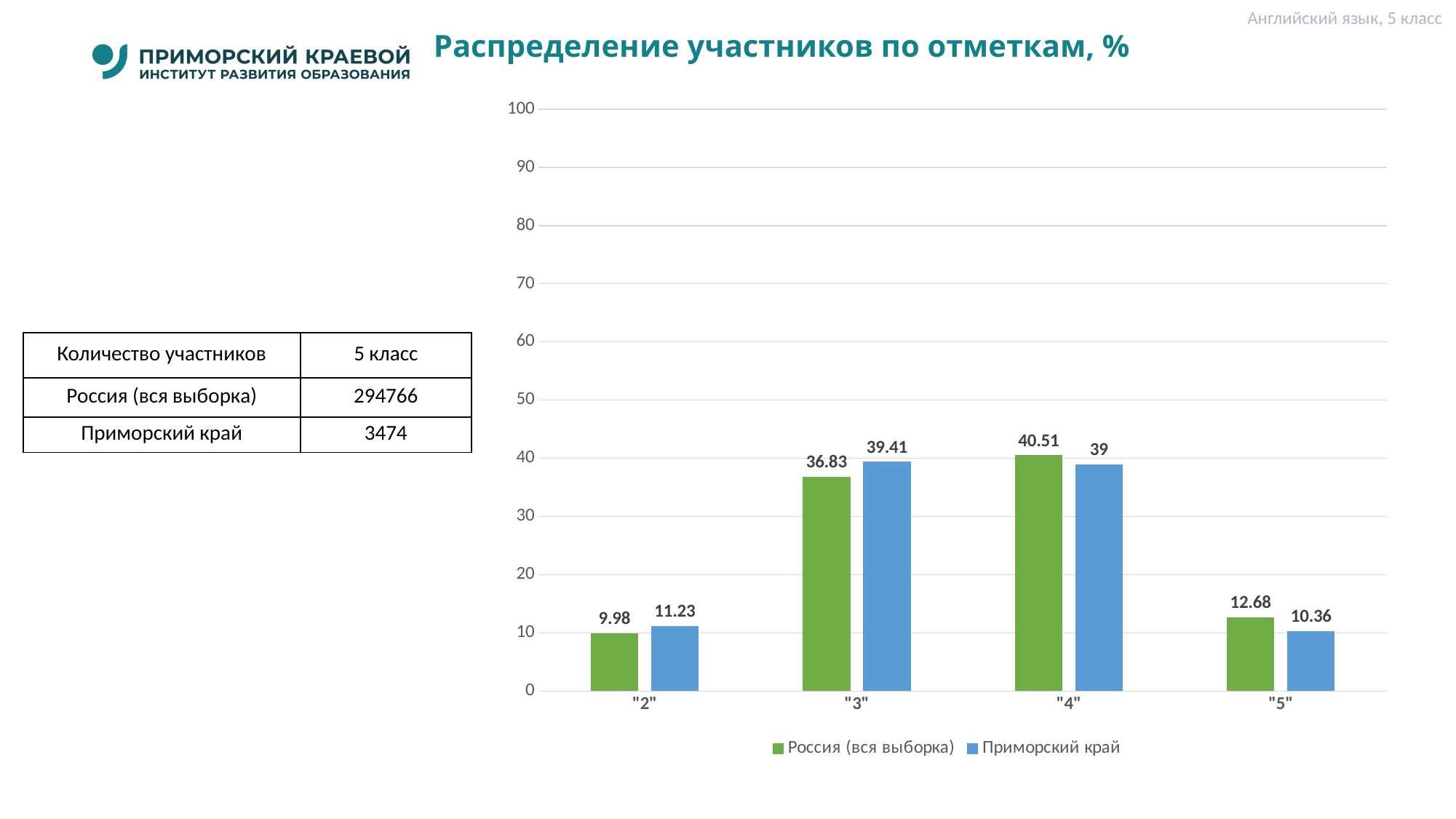
What is the value for Приморский край for mark "4"? 39 Which mark has the highest value for Россия (вся выборка)? "4" Is the value for Приморский край for mark "3" greater or less than 30? greater What is the difference between Приморский край and Россия (вся выборка) for mark "3"? 2.58 How many series does the legend list? 2 What is the value for Приморский край for mark "2"? 11.23 What is the value for Россия (вся выборка) for mark "5"? 12.68 What is the value for Россия (вся выборка) for mark "3"? 36.83 How many mark categories are shown on the x axis? 4 What type of chart is shown on the slide? bar chart Which mark has the lowest value for Приморский край? "5" For mark "5", which series has the larger value: Россия (вся выборка) or Приморский край? Россия (вся выборка)